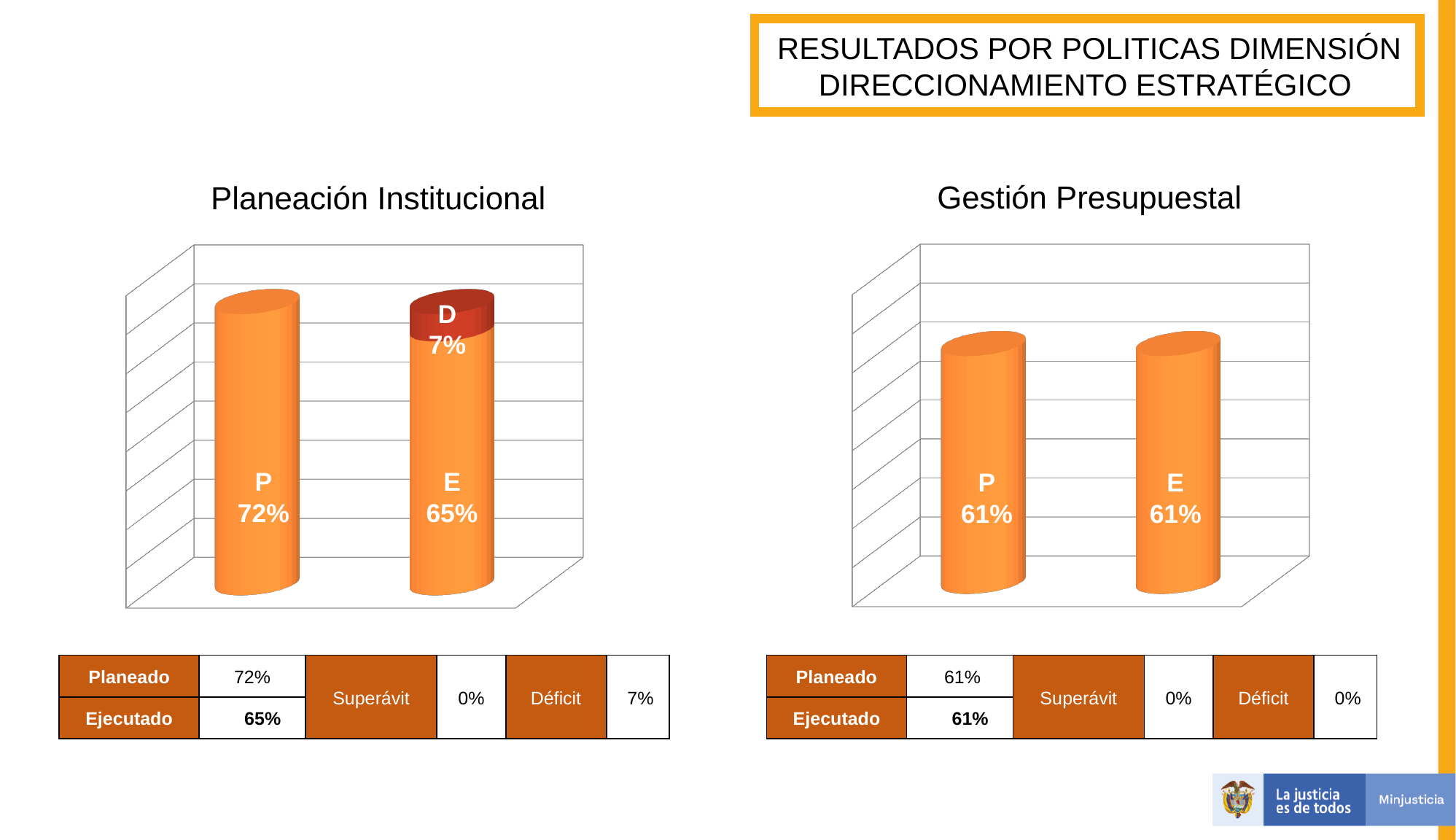
In the 'Planeación Institucional' chart, what is the value labelled E? 65% In the 'Planeación Institucional' chart, what is the value of the D segment on the E bar? 7% In the 'Planeación Institucional' chart, what is the total of the stacked E bar (E plus D)? 72% In the 'Gestión Presupuestal' chart, what is the value labelled E? 61% In the 'Planeación Institucional' chart, what colour is the D segment on top of the E bar? Dark red In the 'Planeación Institucional' chart, which is larger, P or E? P How many bars are shown in the 'Gestión Presupuestal' chart? 2 In the 'Gestión Presupuestal' chart, what is the difference between the P value and the E value? 0% What kind of chart is the 'Planeación Institucional' chart? Bar chart In the 'Gestión Presupuestal' chart, what is the value labelled P? 61% In the 'Planeación Institucional' chart, what is the difference between the P value and the E value? 7% In the 'Planeación Institucional' chart, what is the value labelled P? 72%